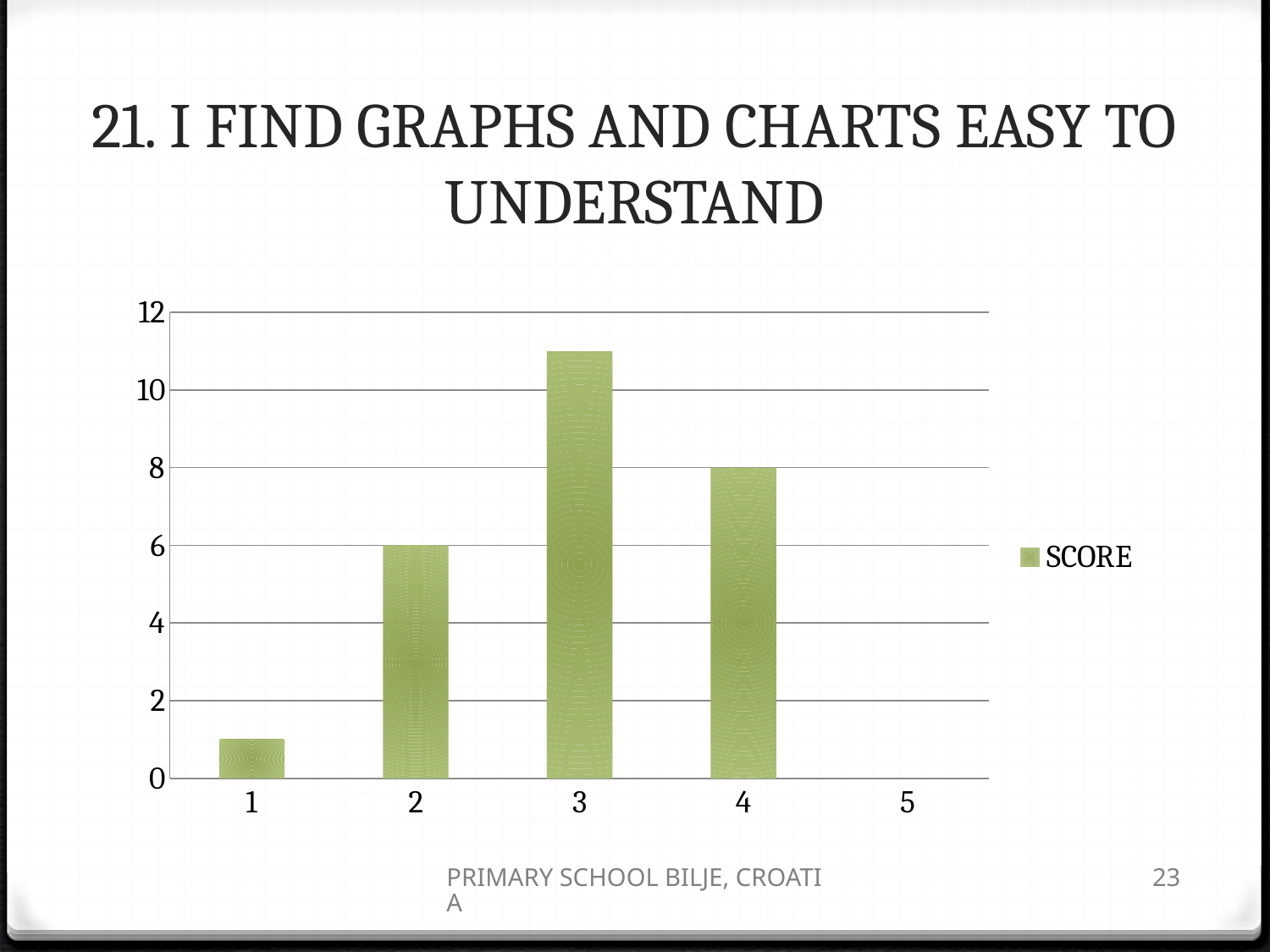
Among the bars shown, which category has the shortest bar? 1 How many series does the legend list? 1 What kind of chart is shown on the slide? bar chart Which category has the tallest bar? 3 Which category has no bar at all? 5 What is the value for category 4? 8 Is the value for category 1 greater or less than 2? less Which is larger, the value for category 2 or the value for category 4? category 4 Is the value for category 3 greater or less than 10? greater How many categories are shown on the x axis? 5 What is the value for category 2? 6 What is the difference between the values for category 4 and category 2? 2